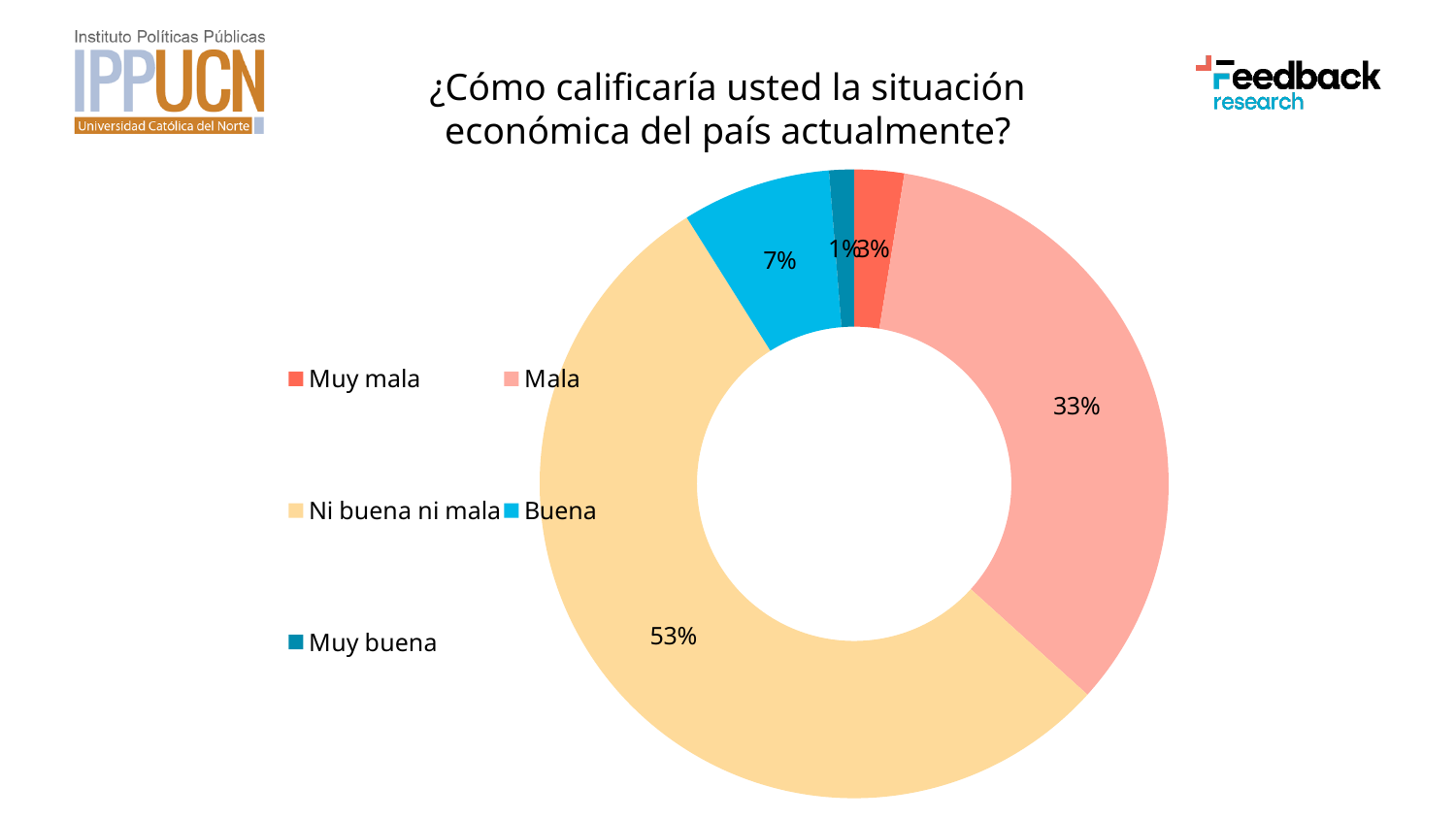
What percentage of respondents rated the economic situation as "Buena"? 7% What kind of chart is shown on the slide? Doughnut chart Which category has the largest share of the chart? Ni buena ni mala What percentage of respondents rated the economic situation as "Mala"? 33% Which is larger, the share for "Mala" or the share for "Buena"? Mala What is the difference in percentage points between "Ni buena ni mala" and "Mala"? 20 What percentage of respondents rated the economic situation as "Muy mala"? 3% How many categories does the chart show? 5 Which category has the smallest share of the chart? Muy buena What is the combined share of "Muy mala" and "Mala"? 36% What percentage of respondents rated the economic situation as "Ni buena ni mala"? 53% What colour is used for the "Ni buena ni mala" category? Light yellow